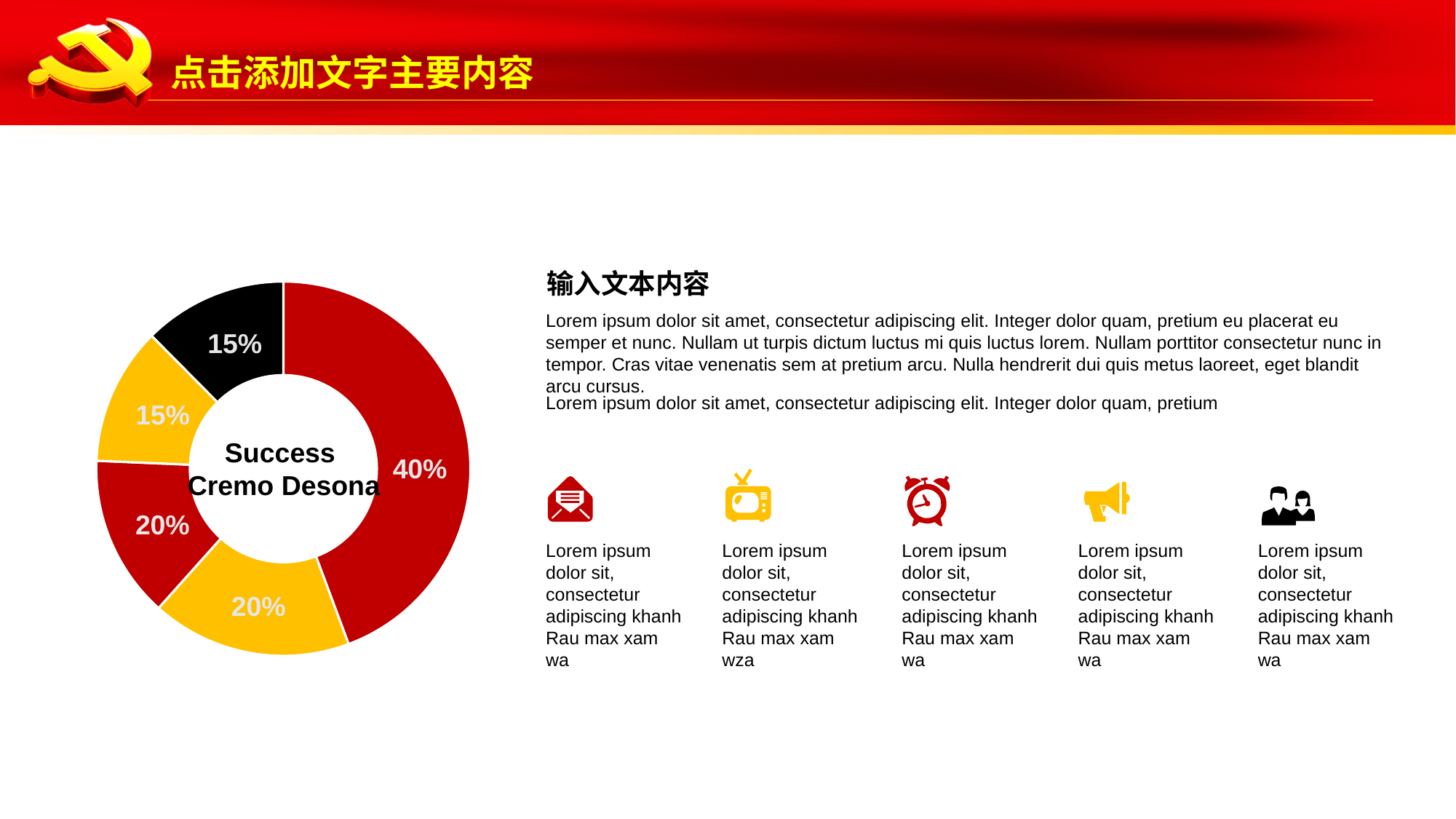
What value is labelled on the yellow slice at the bottom of the doughnut chart? 20% What is the value of the largest slice in the doughnut chart? 40% What value is labelled on the large red slice on the right side of the doughnut chart? 40% What kind of chart is shown on the left of the slide? doughnut chart What is the value of the smallest slices in the doughnut chart? 15% Which is larger, the black slice or the large red slice on the right? the large red slice on the right What is the difference between the largest slice (40%) and the black slice (15%)? 25 percentage points How many slices in the doughnut chart are labelled 20%? 2 How many slices does the doughnut chart have? 5 Which three colours are used for the slices of the doughnut chart? red, yellow and black What text is written in the centre of the doughnut chart? Success Cremo Desona What value is labelled on the black slice of the doughnut chart? 15%